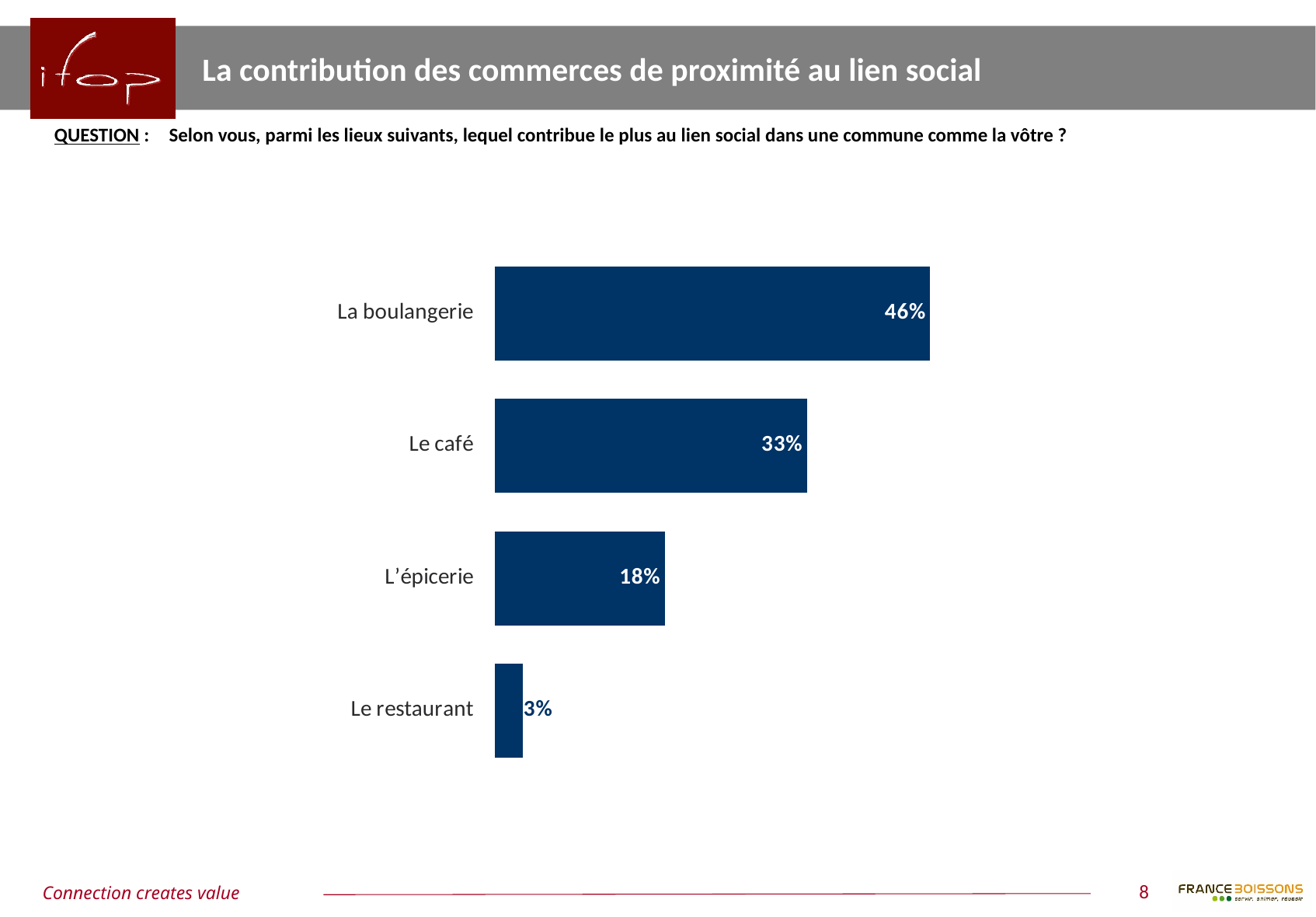
What is the value for Le restaurant? 3% What is the title of the slide containing the chart? La contribution des commerces de proximité au lien social What is the difference between the values for La boulangerie and Le café? 13% What is the value for L'épicerie? 18% Which category has the lowest value? Le restaurant What kind of chart is shown on the slide? Bar chart What is the value for Le café? 33% Which category has the highest value? La boulangerie What is the value for La boulangerie? 46% Which is larger, the value for Le café or the value for L'épicerie? Le café How many categories are shown in the chart? 4 What is the difference between the values for L'épicerie and Le restaurant? 15%